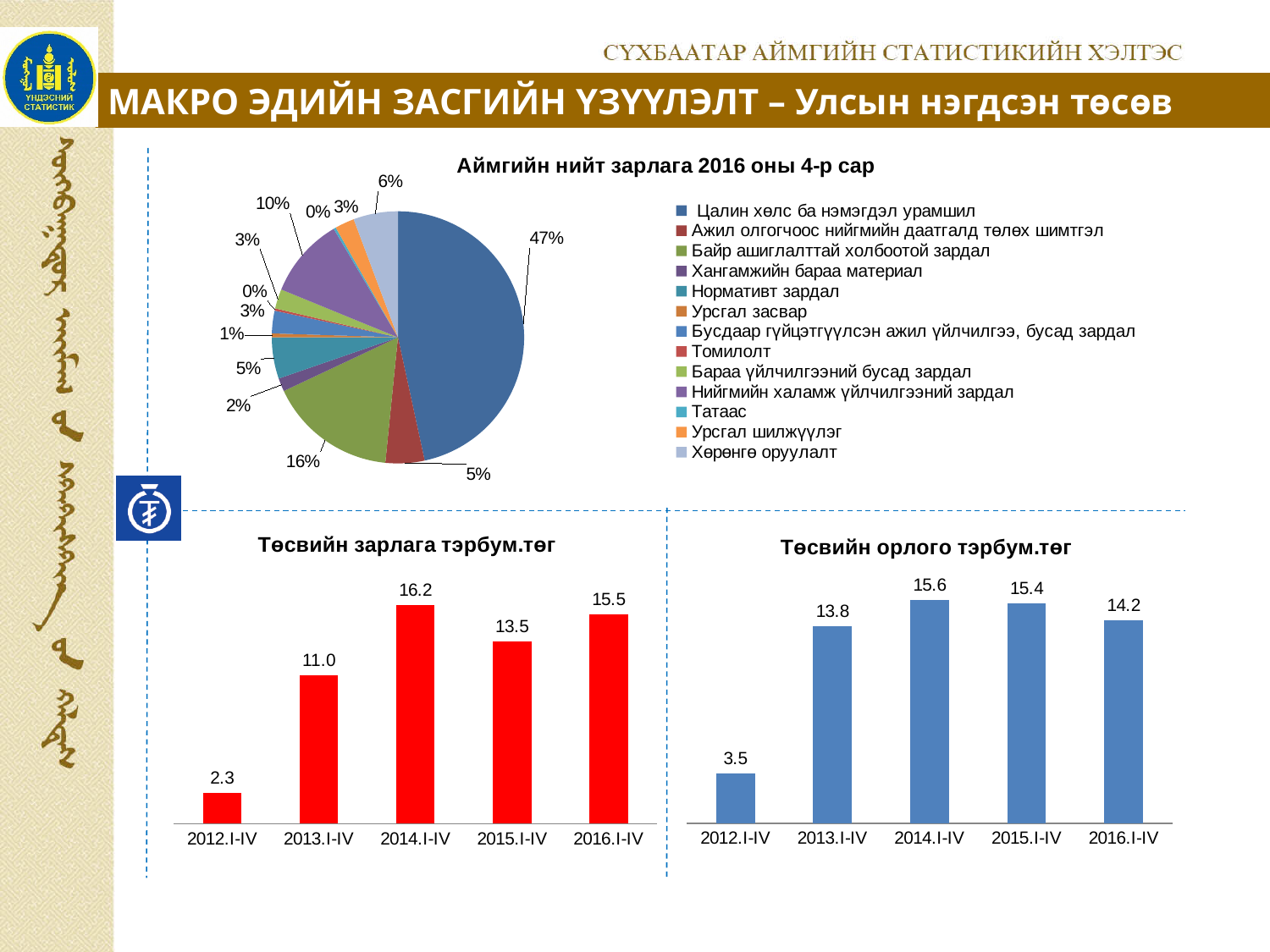
How many periods are shown on the x axis of the chart titled 'Төсвийн орлого тэрбум.төг'? 5 In the chart titled 'Төсвийн орлого тэрбум.төг', which period has the highest value? 2014.I-IV In the chart titled 'Төсвийн зарлага тэрбум.төг', which is larger, the value for 2013.I-IV or the value for 2016.I-IV? 2016.I-IV What kind of chart is 'Төсвийн зарлага тэрбум.төг'? bar chart In the chart titled 'Төсвийн зарлага тэрбум.төг', what is the difference between the values for 2014.I-IV and 2015.I-IV? 2.7 In the pie chart titled 'Аймгийн нийт зарлага 2016 оны 4-р сар', what share does the largest slice have? 47% What kind of chart is 'Аймгийн нийт зарлага 2016 оны 4-р сар'? pie chart In the chart titled 'Төсвийн орлого тэрбум.төг', what is the difference between the values for 2013.I-IV and 2012.I-IV? 10.3 In the chart titled 'Төсвийн орлого тэрбум.төг', what is the value for 2016.I-IV? 14.2 In the chart titled 'Төсвийн зарлага тэрбум.төг', what is the value for 2014.I-IV? 16.2 How many entries does the legend of the pie chart 'Аймгийн нийт зарлага 2016 оны 4-р сар' list? 13 In the chart titled 'Төсвийн зарлага тэрбум.төг', which period has the lowest value? 2012.I-IV